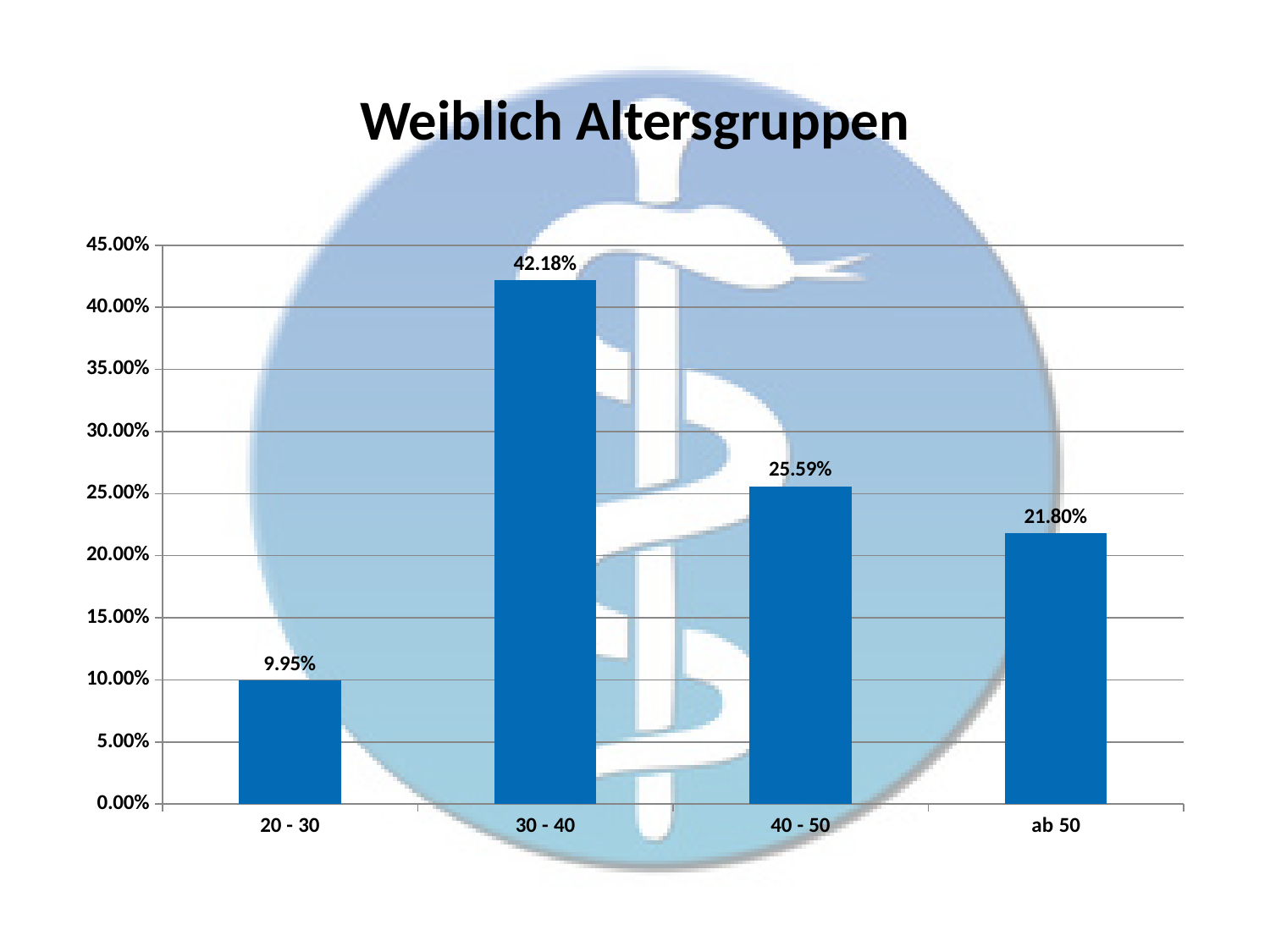
What is the difference between the values for 30 - 40 and 40 - 50? 16.59% What is the value for the 20 - 30 age group? 9.95% What is the value for the ab 50 age group? 21.80% What is the value for the 40 - 50 age group? 25.59% What kind of chart is shown on the slide? Bar chart Which age group has the highest value? 30 - 40 Which age group has the lowest value? 20 - 30 What is the difference between the values for ab 50 and 20 - 30? 11.85% What is the value for the 30 - 40 age group? 42.18% How many age groups are shown in the chart? 4 Is the value for 30 - 40 greater or less than 40.00%? greater Which is larger, the value for 40 - 50 or the value for ab 50? 40 - 50